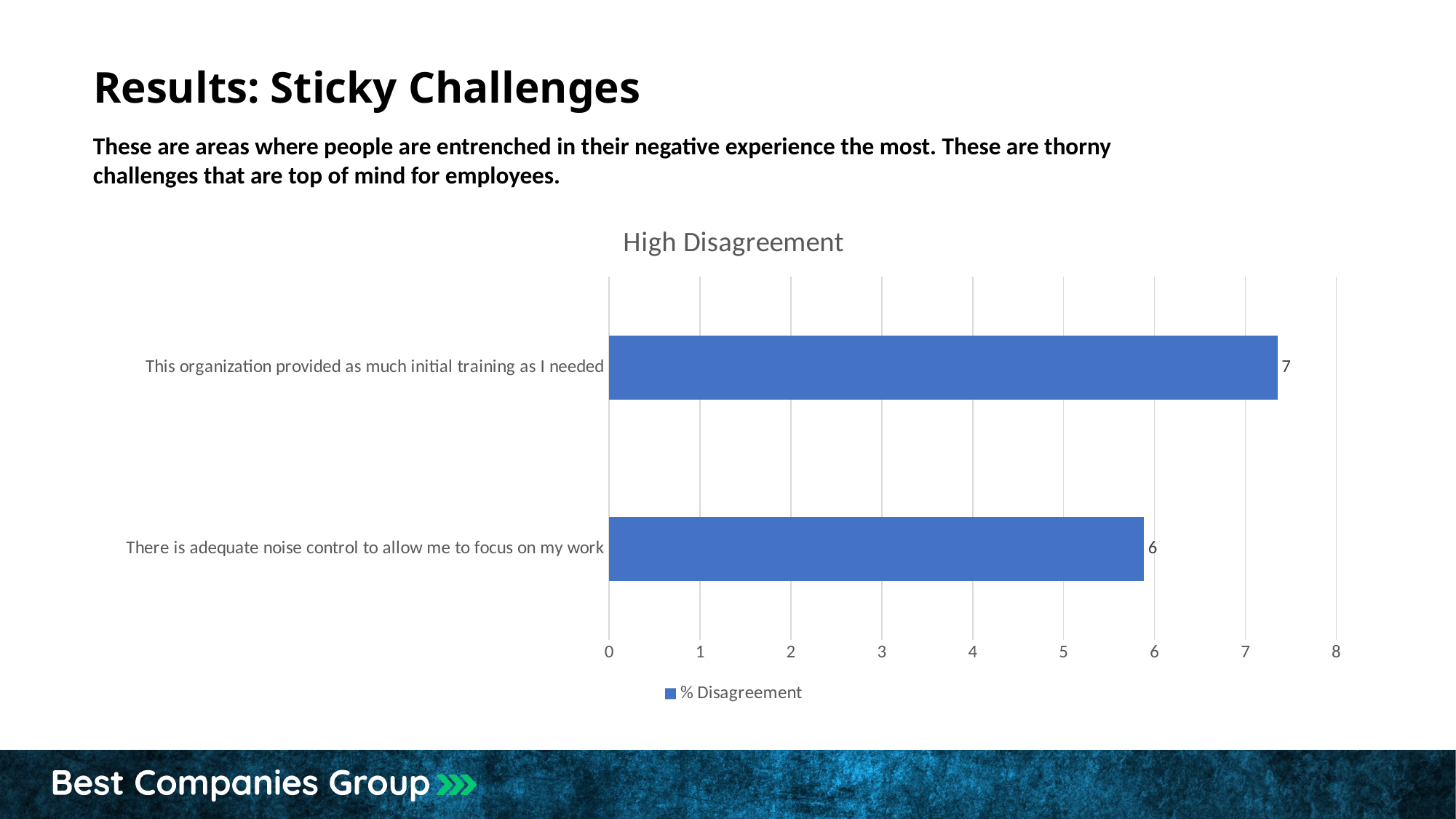
How many series does the legend list? 1 Is the value for "This organization provided as much initial training as I needed" greater or less than 5? greater Which has a larger % Disagreement: the initial training item or the noise control item? This organization provided as much initial training as I needed What is the difference between the % Disagreement values for the initial training item and the noise control item? 1 What is the title of the chart? High Disagreement What is the % Disagreement value for "This organization provided as much initial training as I needed"? 7 Which category has the lowest % Disagreement? There is adequate noise control to allow me to focus on my work How many categories are shown in the chart? 2 What kind of chart is shown on the slide? Bar chart Is the value for "There is adequate noise control to allow me to focus on my work" greater or less than 8? less Which category has the highest % Disagreement? This organization provided as much initial training as I needed What is the % Disagreement value for "There is adequate noise control to allow me to focus on my work"? 6